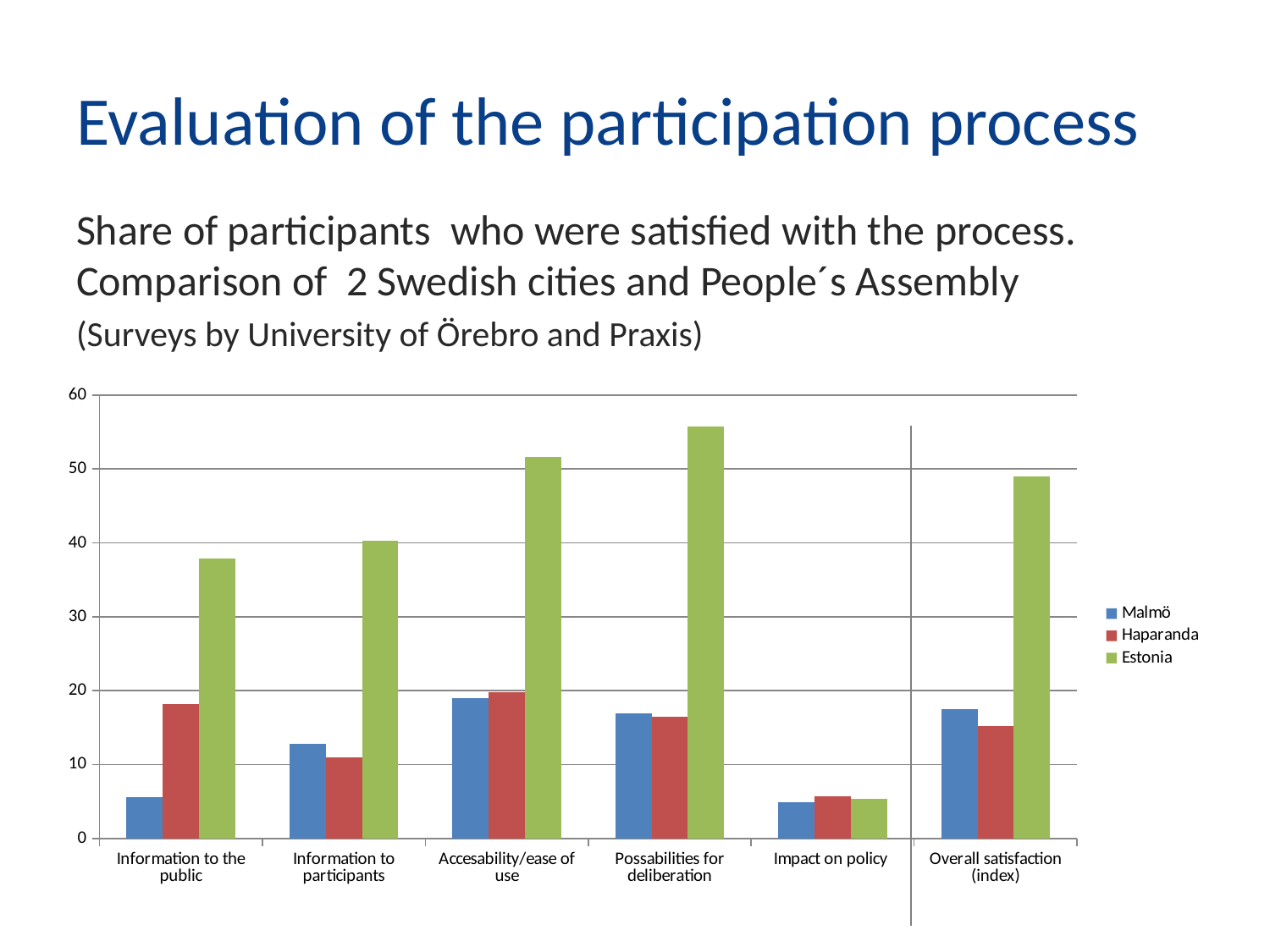
Is the value for Estonia in Possabilities for deliberation greater or less than 50? greater For Information to the public, which is larger: the value for Malmö or the value for Haparanda? Haparanda How many series does the chart's legend list? 3 In which category does Estonia reach its highest value? Possabilities for deliberation How many categories are shown along the x axis of the chart? 6 Which colour represents Estonia in the chart? green In which category does Estonia have its lowest value? Impact on policy For Information to participants, which is larger: the value for Malmö or the value for Haparanda? Malmö Is the value for Estonia in Overall satisfaction (index) greater or less than 40? greater Which series are listed in the chart's legend? Malmö, Haparanda, Estonia Is the value for Malmö in Information to the public greater or less than 10? less What kind of chart is shown on the slide? bar chart